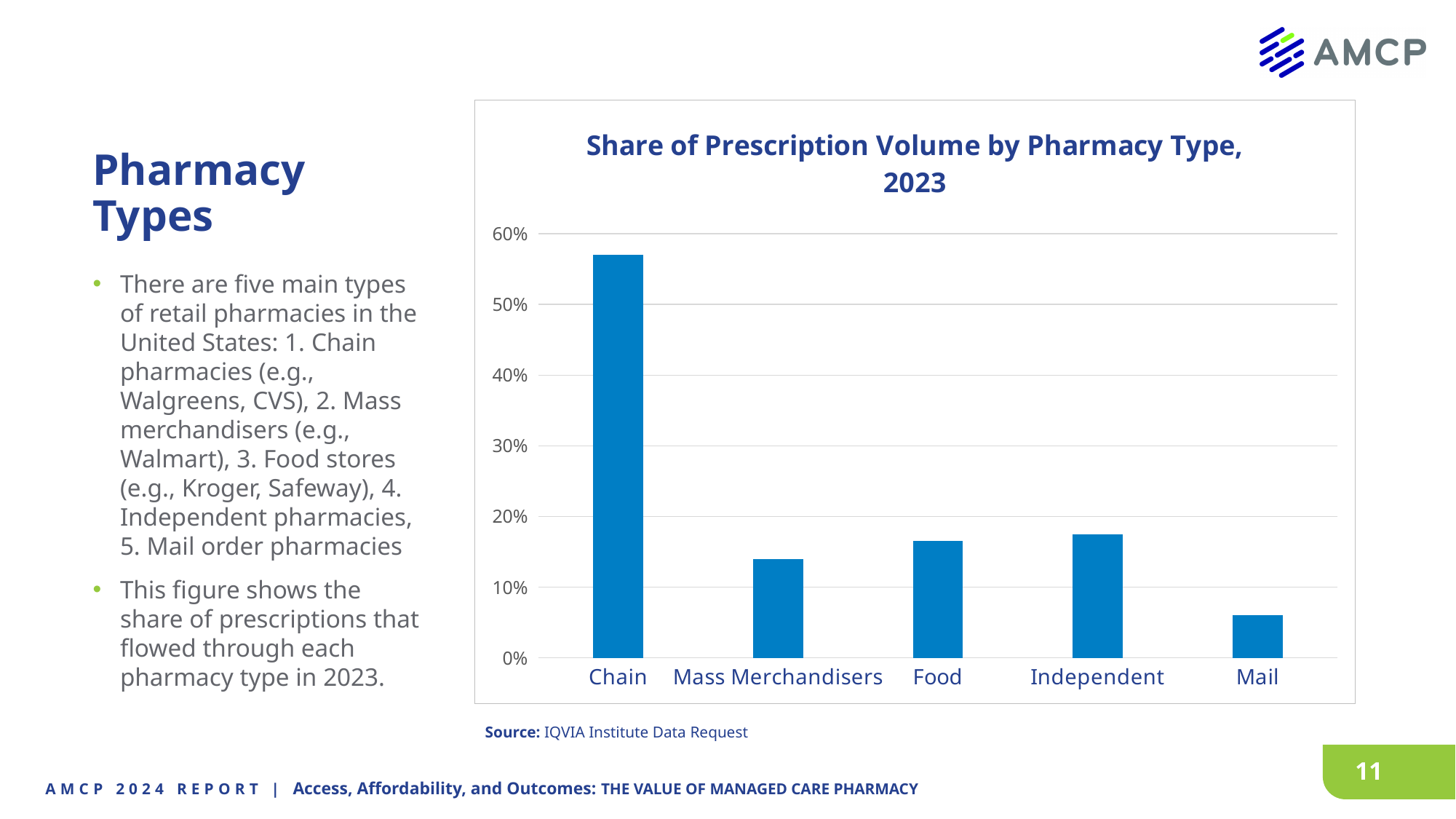
Which pharmacy type has the highest share of prescription volume? Chain How many pharmacy types are shown on the x axis of the chart? 5 Is the value for Independent greater or less than 20%? less Which has a larger share of prescription volume, Mass Merchandisers or Food? Food What type of chart is shown on the slide? bar chart Is the value for Mail greater or less than 10%? less Which has a larger share of prescription volume, Mail or Independent? Independent Is the value for Food greater or less than 20%? less Which pharmacy type has the lowest share of prescription volume? Mail What is the title of the chart? Share of Prescription Volume by Pharmacy Type, 2023